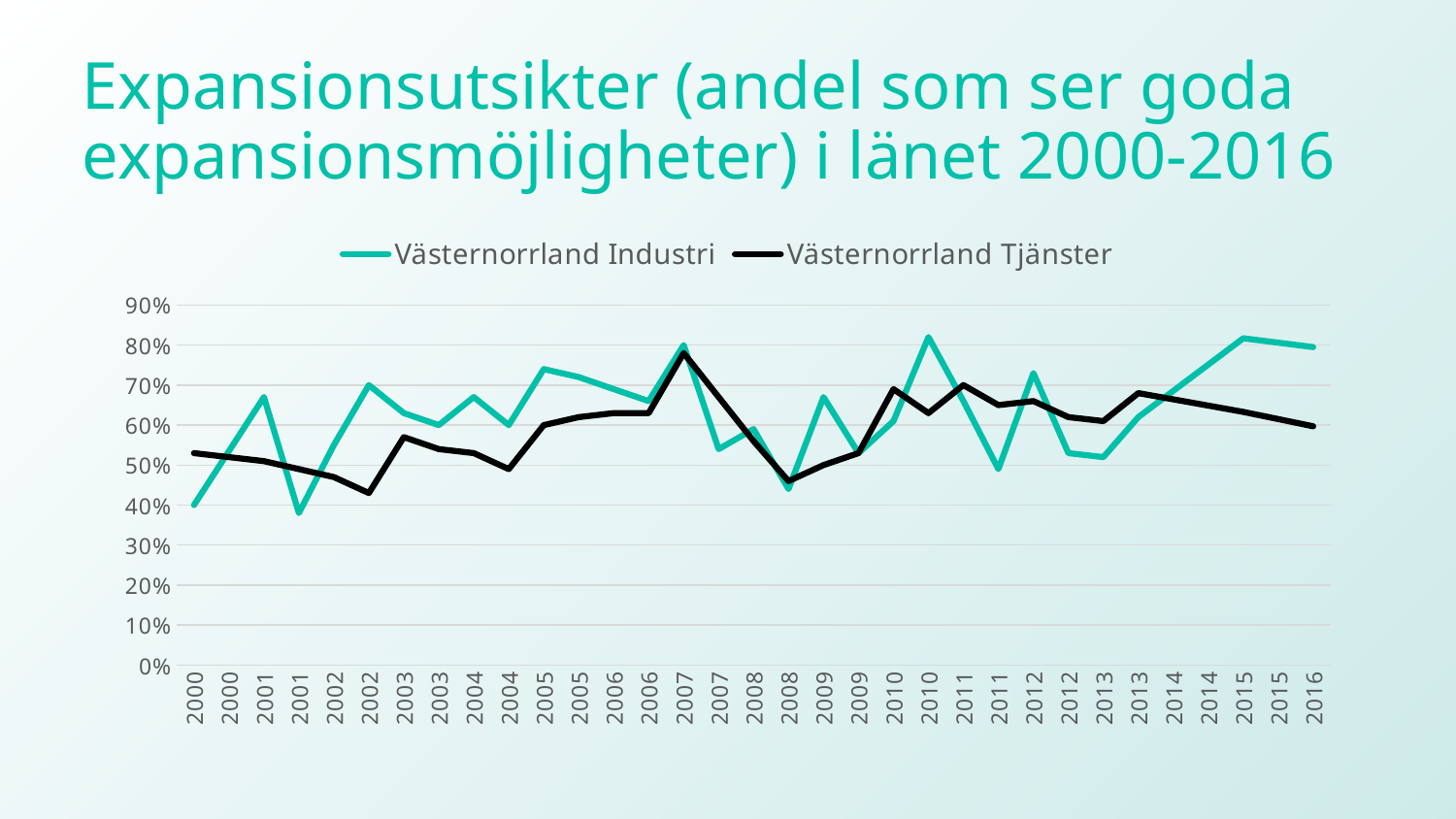
Is the value for Västernorrland Industri at the second 2010 point greater or less than 70%? greater Which two series are listed in the legend? Västernorrland Industri and Västernorrland Tjänster Does the Västernorrland Tjänster line rise or fall from the second 2013 point to 2016? fall Is the value for Västernorrland Tjänster at the first 2007 point greater or less than 70%? greater At the first 2001 point, which series has the higher value, Västernorrland Industri or Västernorrland Tjänster? Västernorrland Industri What colour is the line for Västernorrland Tjänster? black How many series does the legend list? 2 Is the value for Västernorrland Industri at the first 2000 point greater or less than 50%? less At the first 2015 point, which series has the higher value, Västernorrland Industri or Västernorrland Tjänster? Västernorrland Industri What kind of chart is shown on the slide? line chart